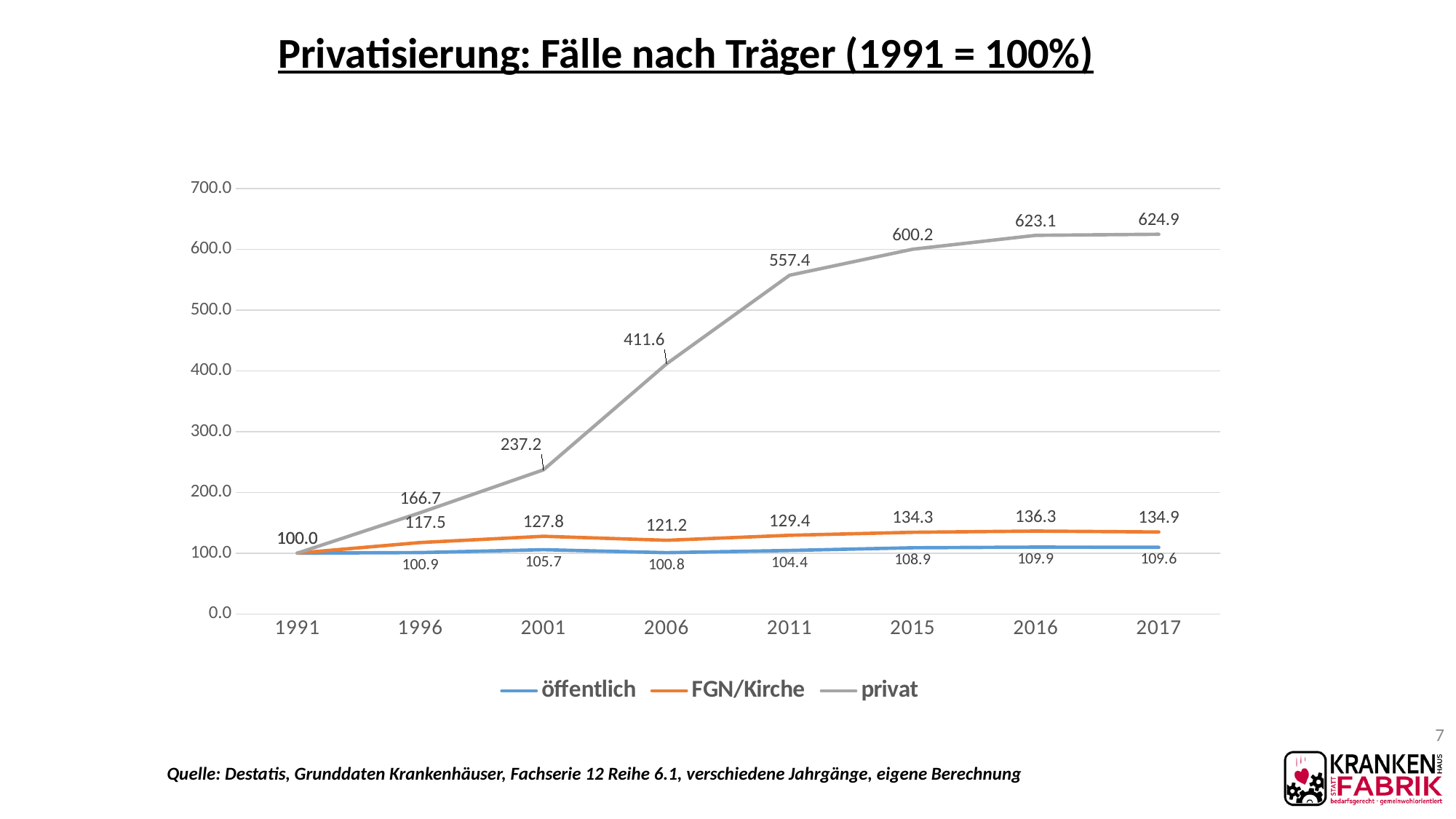
Which series has the lowest value in 2017? öffentlich What type of chart is shown on the slide? line chart Does the privat series generally rise or fall from 1991 to 2017? rise What is the value for öffentlich in 2006? 100.8 How many years are shown on the x axis? 8 What is the value for FGN/Kirche in 2016? 136.3 What is the title of the chart? Privatisierung: Fälle nach Träger (1991 = 100%) Which is larger in 2015: the value for FGN/Kirche or the value for öffentlich? FGN/Kirche How many series does the legend list? 3 What is the value for privat in 2011? 557.4 What is the difference between the privat values in 2006 and 2001? 174.4 In which year does the privat series reach its highest value? 2017